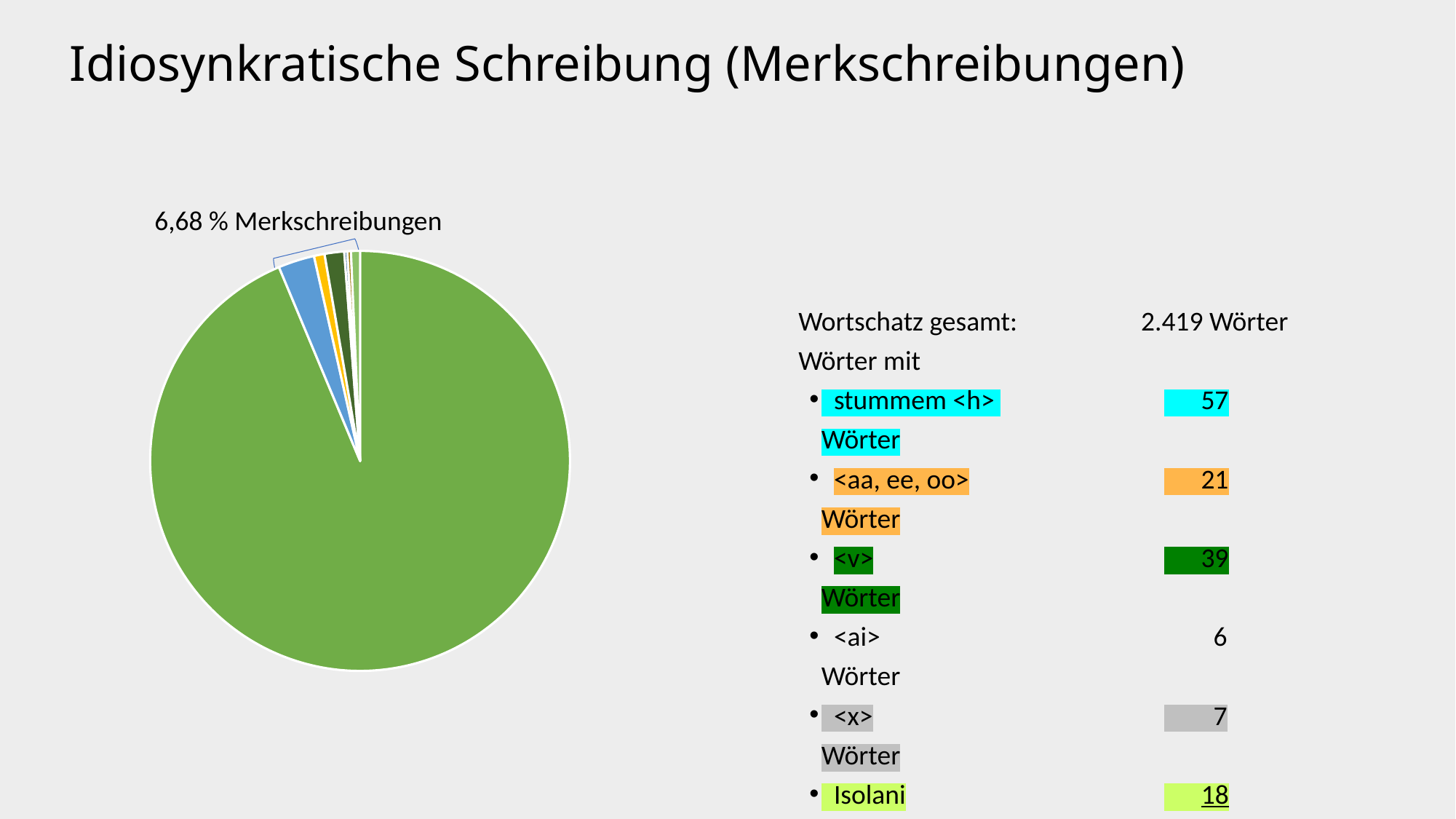
Which of the listed Merkschreibung categories has the highest word count? stummem <h> How many words with <aa, ee, oo> are listed on the slide? 21 How many Isolani are listed on the slide? 18 What is the difference between the number of words with stummem <h> and the number of words with <v>? 18 Which has more words: <x> or <ai>? <x> What kind of chart is shown on the slide? pie chart According to the slide, how many words does the total vocabulary (Wortschatz gesamt) contain? 2.419 Wörter How many Merkschreibung categories are listed on the slide? 6 Which of the listed Merkschreibung categories has the lowest word count? <ai> How many words with <v> are listed on the slide? 39 What percentage of the pie is labelled as Merkschreibungen? 6,68 % How many words with stummem <h> are listed on the slide? 57